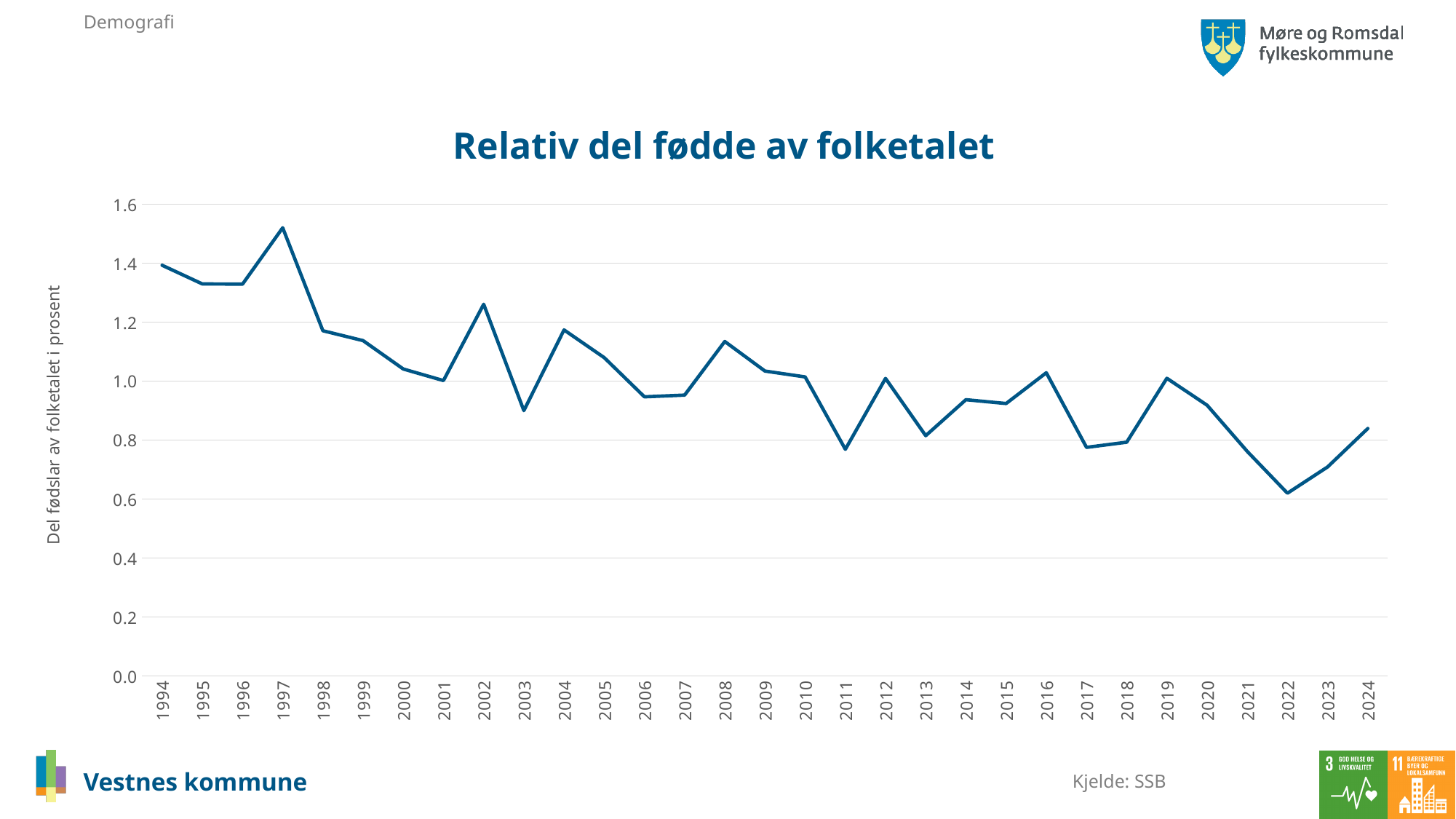
Is the value for 2003 greater or less than 1.0? less Overall, do the values rise or fall from 1994 to 2024? fall How many years are plotted along the x axis of the chart? 31 What is the title of the chart? Relativ del fødde av folketalet Is the value for 1994 greater or less than 1.2? greater What kind of chart is shown on the slide? line chart Is the value for 2022 greater or less than 0.8? less In which year is the value highest? 1997 Which year has the larger value, 1997 or 2002? 1997 In which year is the value lowest? 2022 What is the label on the vertical axis of the chart? Del fødslar av folketalet i prosent